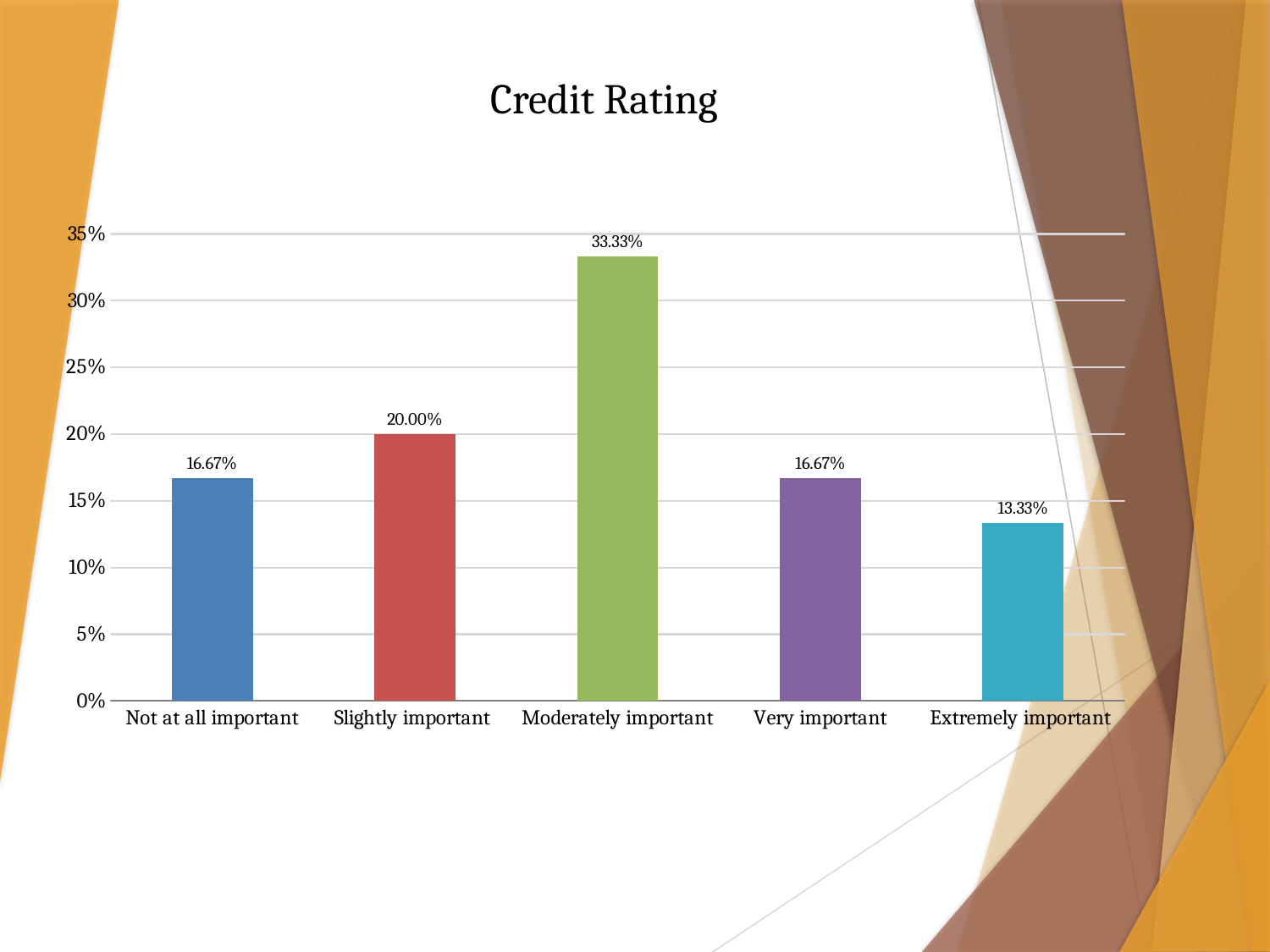
Which is larger, the value for Slightly important or the value for Very important? Slightly important What is the difference between the values for Moderately important and Slightly important? 13.33% Is the value for Very important greater or less than 15%? greater What kind of chart is shown on the slide? bar chart What is the value for Not at all important? 16.67% What is the value for Moderately important? 33.33% Which category has the highest value? Moderately important What is the title of the chart? Credit Rating How many categories are shown on the x axis? 5 Which category has the lowest value? Extremely important What is the value for Extremely important? 13.33% What is the value for Slightly important? 20.00%